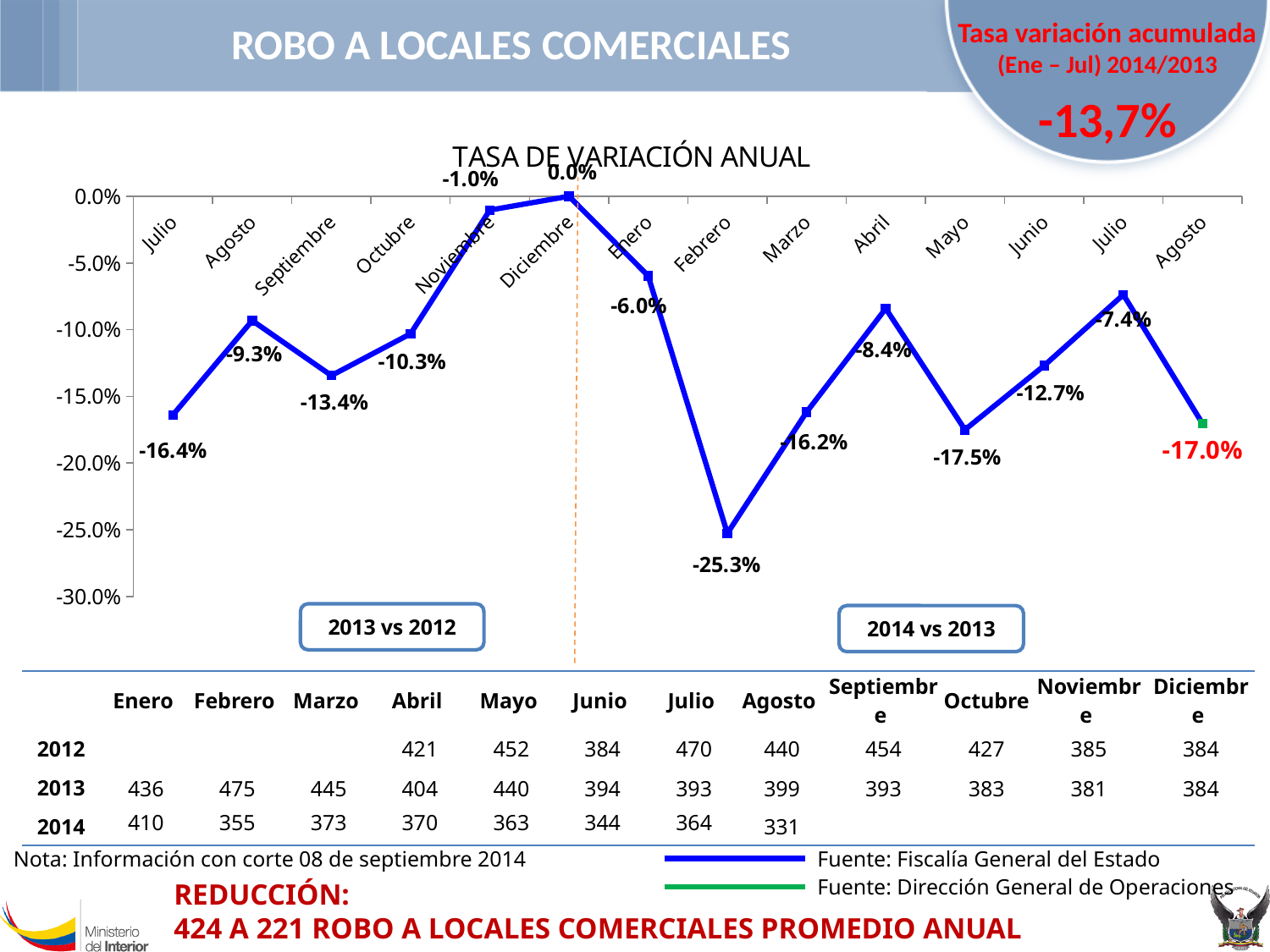
In the 'TASA DE VARIACIÓN ANUAL' chart, which is larger, the value for Septiembre in the 2013 vs 2012 section or the value for Marzo in the 2014 vs 2013 section? Septiembre In the 'TASA DE VARIACIÓN ANUAL' chart, what is the value for Mayo? -17.5% What kind of chart is 'TASA DE VARIACIÓN ANUAL'? line chart In the 'TASA DE VARIACIÓN ANUAL' chart, what is the difference between the values for Abril (-8.4%) and Mayo (-17.5%)? 9.1 percentage points In the 'TASA DE VARIACIÓN ANUAL' chart, what is the value for Diciembre in the 2013 vs 2012 section? 0.0% In the 'TASA DE VARIACIÓN ANUAL' chart, how many data points are plotted? 14 In the 'TASA DE VARIACIÓN ANUAL' chart, which month has the highest value? Diciembre In the 'TASA DE VARIACIÓN ANUAL' chart, do the values rise or fall from Julio to Diciembre in the 2013 vs 2012 section? rise In the 'TASA DE VARIACIÓN ANUAL' chart, what is the value for Febrero in the 2014 vs 2013 section? -25.3% In the 'TASA DE VARIACIÓN ANUAL' chart, which month has the lowest value? Febrero In the 'TASA DE VARIACIÓN ANUAL' chart, what is the value for Agosto in the 2014 vs 2013 section? -17.0% What is the 'Tasa variación acumulada (Ene – Jul) 2014/2013' shown in the top-right circle of the slide? -13,7%